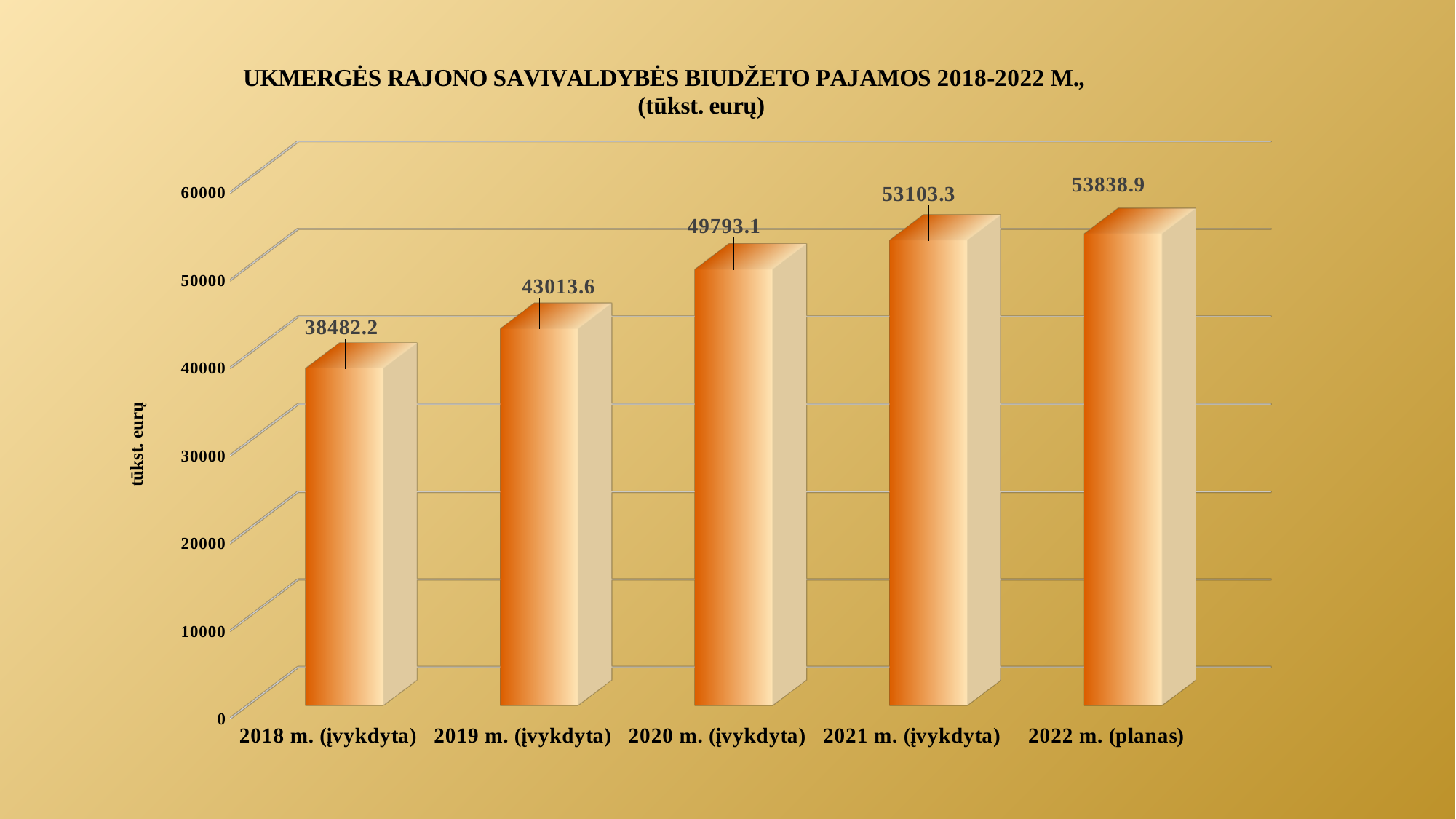
What kind of chart is shown on the slide? bar chart Do the values rise or fall from 2018 to 2022 along the x axis? rise Is the value for 2021 m. (įvykdyta) greater or less than 50000? greater What is the value for 2018 m. (įvykdyta)? 38482.2 How many categories are shown on the x axis? 5 Which category has the lowest value? 2018 m. (įvykdyta) Which category has the highest value? 2022 m. (planas) What is the difference between the values for 2019 m. (įvykdyta) and 2018 m. (įvykdyta)? 4531.4 Which is larger, the value for 2020 m. (įvykdyta) or 2019 m. (įvykdyta)? 2020 m. (įvykdyta) What is the value for 2022 m. (planas)? 53838.9 What is the value for 2020 m. (įvykdyta)? 49793.1 What is the difference between the values for 2022 m. (planas) and 2021 m. (įvykdyta)? 735.6